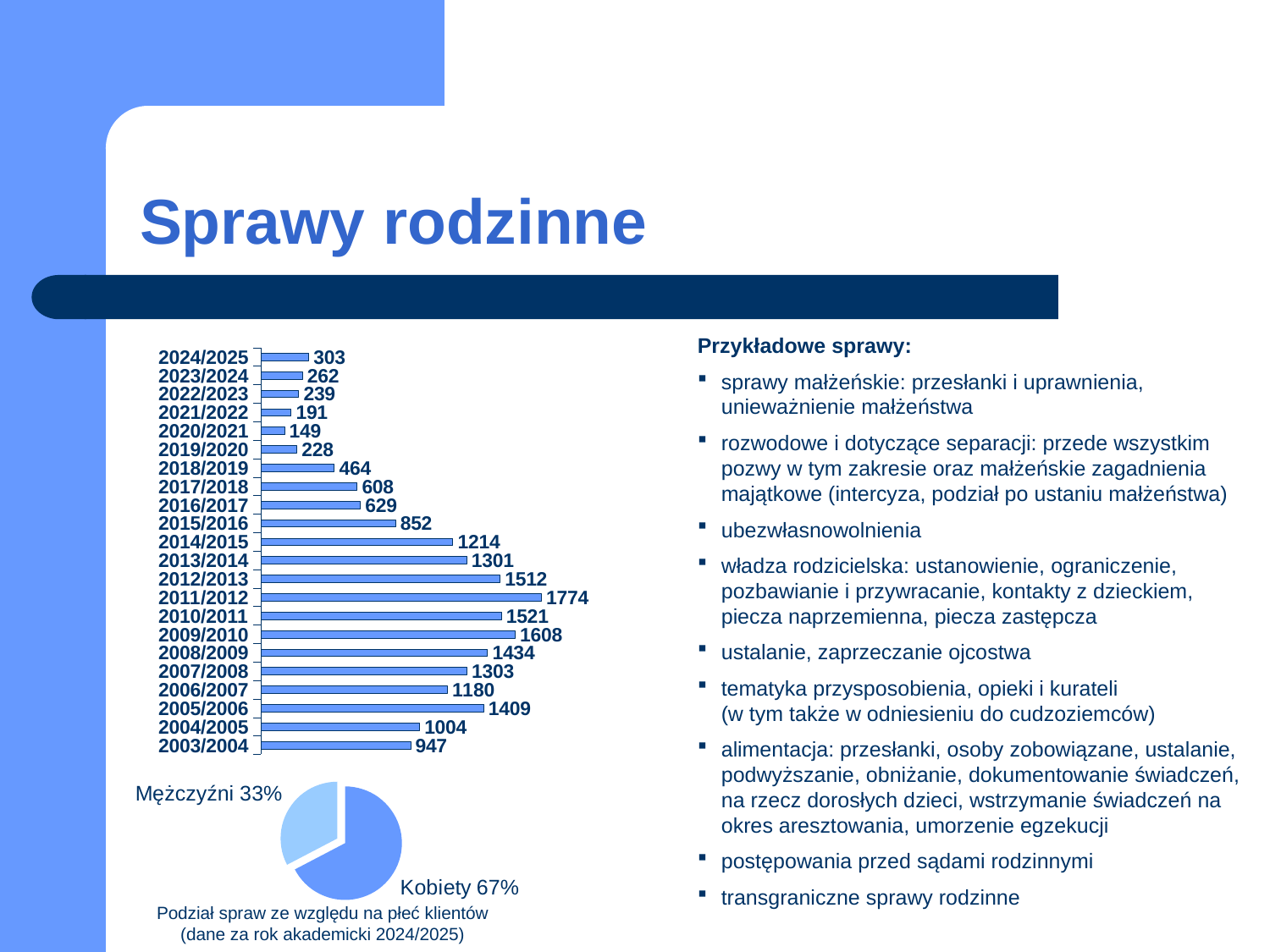
In the pie chart 'Podział spraw ze względu na płeć klientów', what share is Kobiety? 67% In the bar chart, which academic year has the highest value? 2011/2012 In the bar chart, what is the difference between the values for 2024/2025 and 2023/2024? 41 In the bar chart, what is the value for 2011/2012? 1774 In the bar chart, which academic year has the lowest value? 2020/2021 What kind of chart is the chart showing values by academic year? Bar chart In the bar chart, what is the value for 2024/2025? 303 How many academic years are shown in the bar chart? 22 In the bar chart, which is larger: the value for 2016/2017 or the value for 2017/2018? 2016/2017 In the bar chart, what is the value for 2003/2004? 947 In the bar chart, what is the difference between the values for 2009/2010 and 2010/2011? 87 In the pie chart 'Podział spraw ze względu na płeć klientów', what share is Mężczyźni? 33%